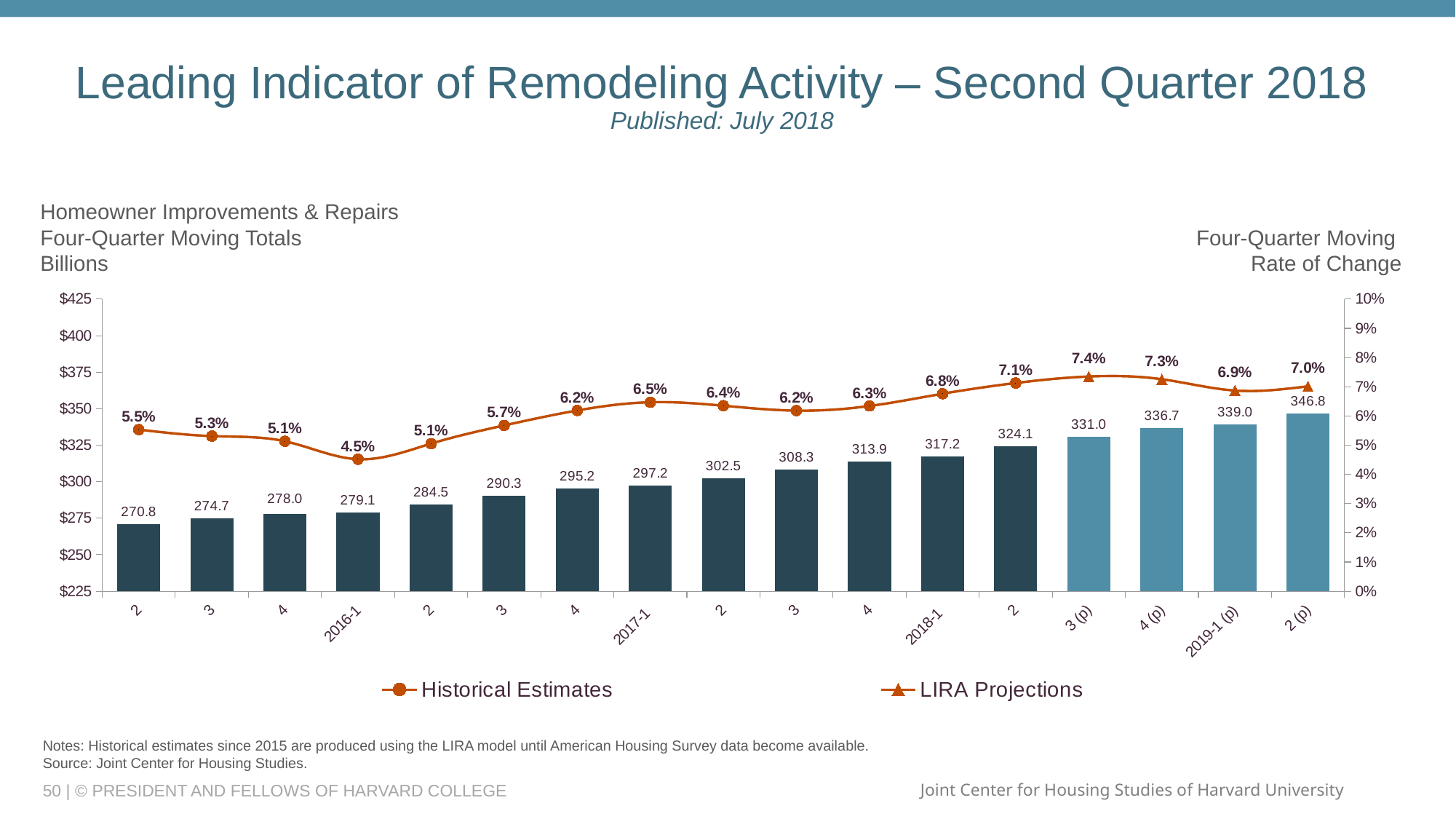
Which is larger, the rate of change for 2017-1 or for 2018-1? 2018-1 Which quarter has the lowest four-quarter moving total? 2 Is the four-quarter moving total for 2017-1 greater or less than $300? less What is the four-quarter moving total for 2018-1? 317.2 What are the two series named in the legend? Historical Estimates and LIRA Projections Which quarter has the highest four-quarter moving rate of change? 3 (p) How many bars are plotted in the chart? 17 How many series does the legend list? 2 Do the four-quarter moving totals rise or fall from left to right along the x axis? rise What is the difference between the four-quarter moving totals for 2 (p) and 2018-1? 29.6 What is the projected four-quarter moving total for 2019-1 (p)? 339.0 What is the four-quarter moving rate of change for 2016-1? 4.5%